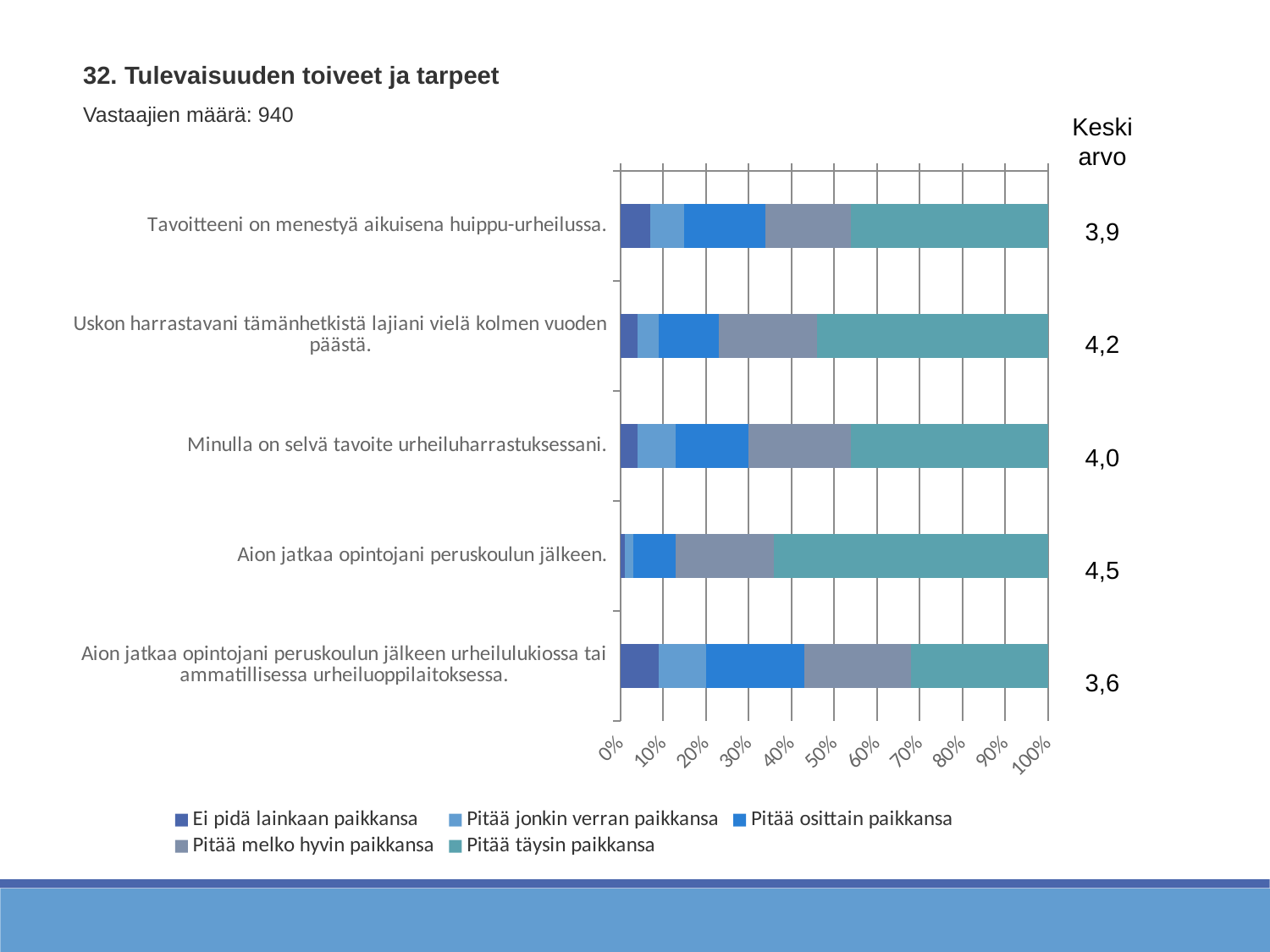
What is the difference between the highest Keskiarvo (4,5) and the lowest Keskiarvo (3,6)? 0,9 How many respondents (Vastaajien määrä) does the slide report? 940 What kind of chart is shown on the slide? Stacked bar chart How many statements (categories) are plotted in the chart? 5 How many series does the legend list? 5 Which has the larger Keskiarvo: "Uskon harrastavani tämänhetkistä lajiani vielä kolmen vuoden päästä." or "Minulla on selvä tavoite urheiluharrastuksessani."? Uskon harrastavani tämänhetkistä lajiani vielä kolmen vuoden päästä. What is the Keskiarvo (mean) shown for "Minulla on selvä tavoite urheiluharrastuksessani."? 4,0 What is the Keskiarvo (mean) shown for "Tavoitteeni on menestyä aikuisena huippu-urheilussa."? 3,9 What is the Keskiarvo (mean) shown for "Aion jatkaa opintojani peruskoulun jälkeen."? 4,5 Is the "Pitää täysin paikkansa" share for "Aion jatkaa opintojani peruskoulun jälkeen." greater or less than 50%? greater Which statement has the highest Keskiarvo (mean)? Aion jatkaa opintojani peruskoulun jälkeen. Which statement has the lowest Keskiarvo (mean)? Aion jatkaa opintojani peruskoulun jälkeen urheilulukiossa tai ammatillisessa urheiluoppilaitoksessa.